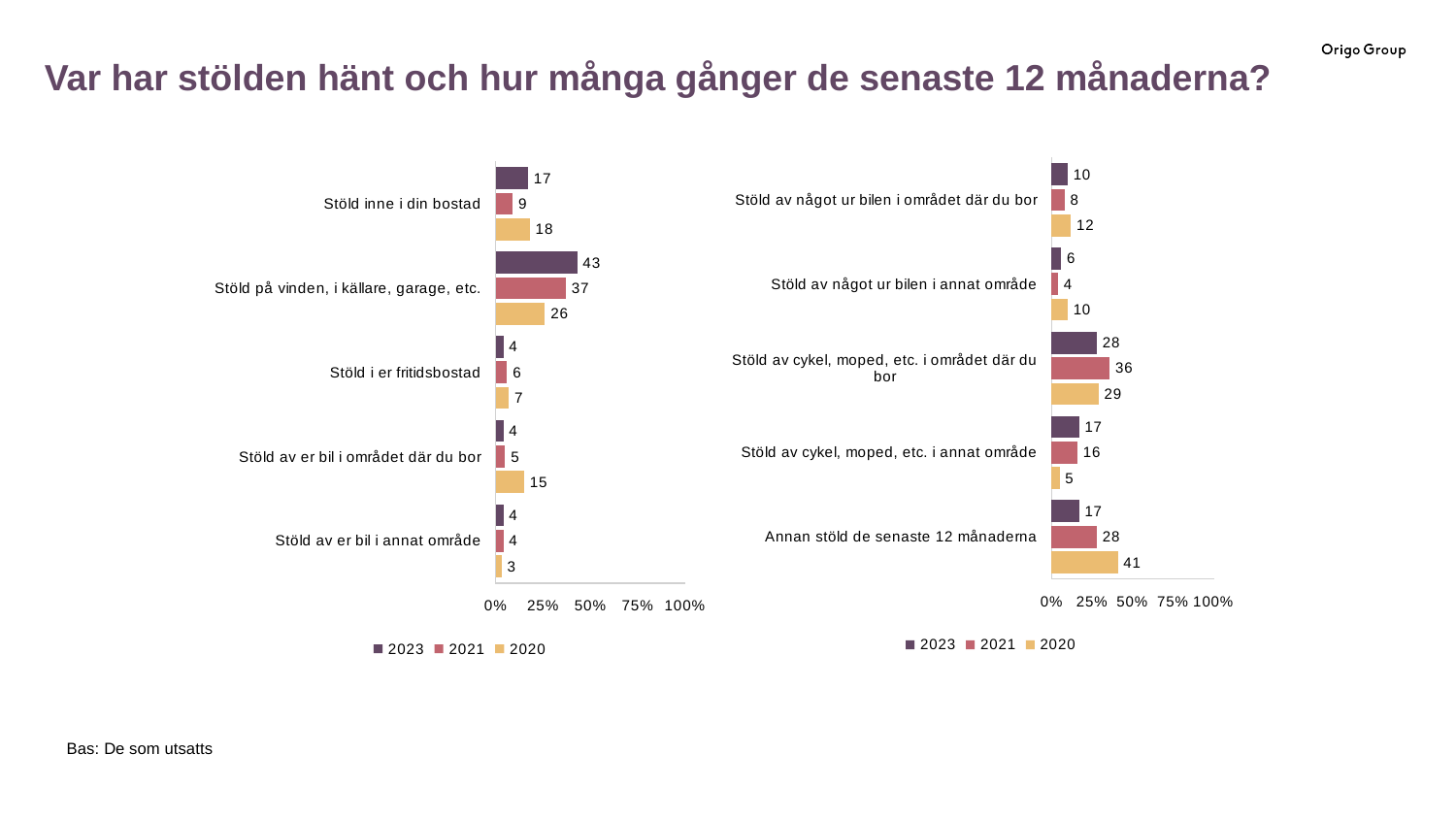
How many series does the legend of the right chart list? 3 In the right chart, which is larger for "Stöld av cykel, moped, etc. i annat område": the 2023 value or the 2020 value? 2023 What type of chart is the left chart? Bar chart In the left chart, which category has the highest 2023 value? Stöld på vinden, i källare, garage, etc. In the right chart, what is the 2021 value for "Stöld av cykel, moped, etc. i området där du bor"? 36 How many categories does the left chart show? 5 In the left chart, what is the 2020 value for "Stöld av er bil i området där du bor"? 15 In the left chart, what is the 2023 value for "Stöld på vinden, i källare, garage, etc."? 43 In the left chart, what is the difference between the 2023 and 2021 values for "Stöld inne i din bostad"? 8 In the right chart, which category has the lowest 2021 value? Stöld av något ur bilen i annat område In the right chart, what is the difference between the 2020 and 2023 values for "Annan stöld de senaste 12 månaderna"? 24 In the right chart, what is the 2020 value for "Annan stöld de senaste 12 månaderna"? 41